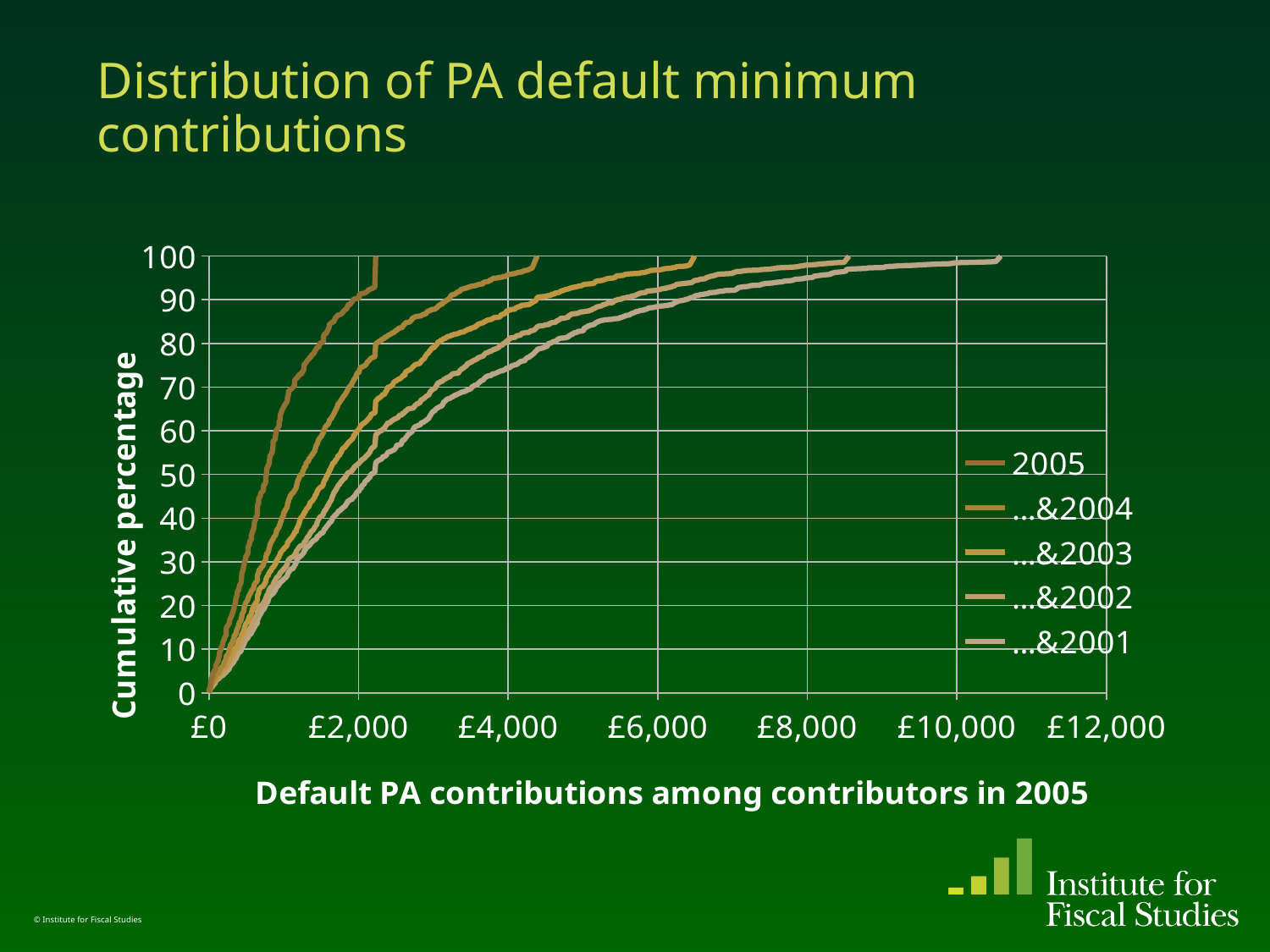
At £4,000, is the cumulative percentage for the ...&2004 series greater or less than 90? greater Do the cumulative percentage values rise or fall as default PA contributions increase along the x axis? Rise What is the title of the chart? Distribution of PA default minimum contributions At £4,000, which series has the higher cumulative percentage, ...&2003 or ...&2001? ...&2003 What kind of chart is shown on the slide? Line chart Which series reaches 100% at the highest contribution level? ...&2001 At £2,000, is the cumulative percentage for the 2005 series greater or less than 80? greater How many series does the legend list? 5 At £6,000, is the cumulative percentage for the ...&2001 series greater or less than 80? greater What is the label on the vertical axis? Cumulative percentage At £2,000, which series has the highest cumulative percentage? 2005 Which series reaches 100% at the lowest contribution level? 2005